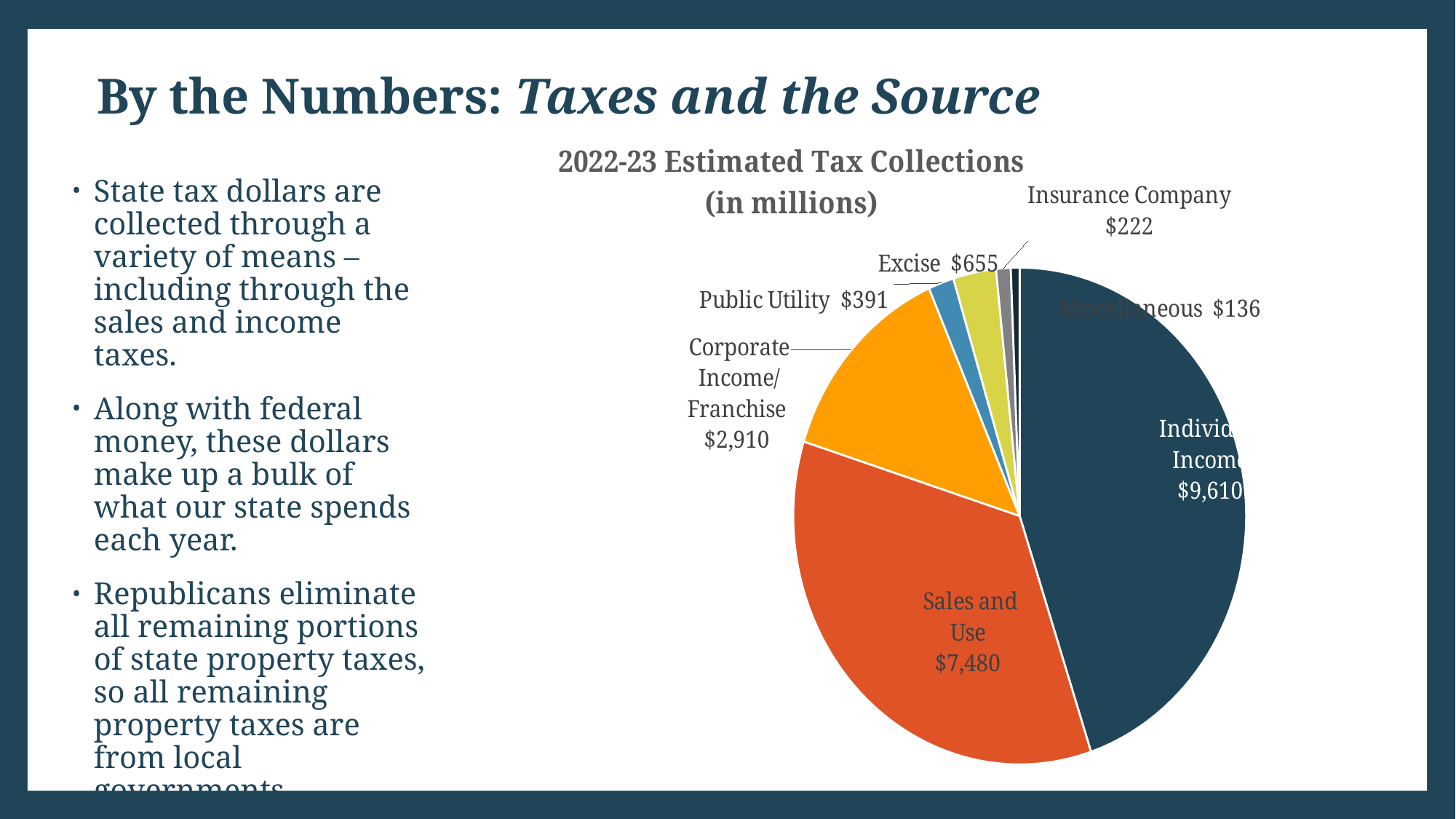
What is the value for Corporate Income/Franchise? $2,910 What is the difference between Individual Income and Sales and Use? $2,130 How many categories are shown in the pie chart? 7 What is the value for Individual Income? $9,610 What is the title of the chart? 2022-23 Estimated Tax Collections (in millions) What is the value for Excise? $655 What kind of chart is shown on the slide? Pie chart Which category has the largest slice of the pie? Individual Income Which is larger, Insurance Company or Miscellaneous? Insurance Company Which is larger, Excise or Public Utility? Excise Which category has the smallest slice of the pie? Miscellaneous What is the value for Sales and Use? $7,480